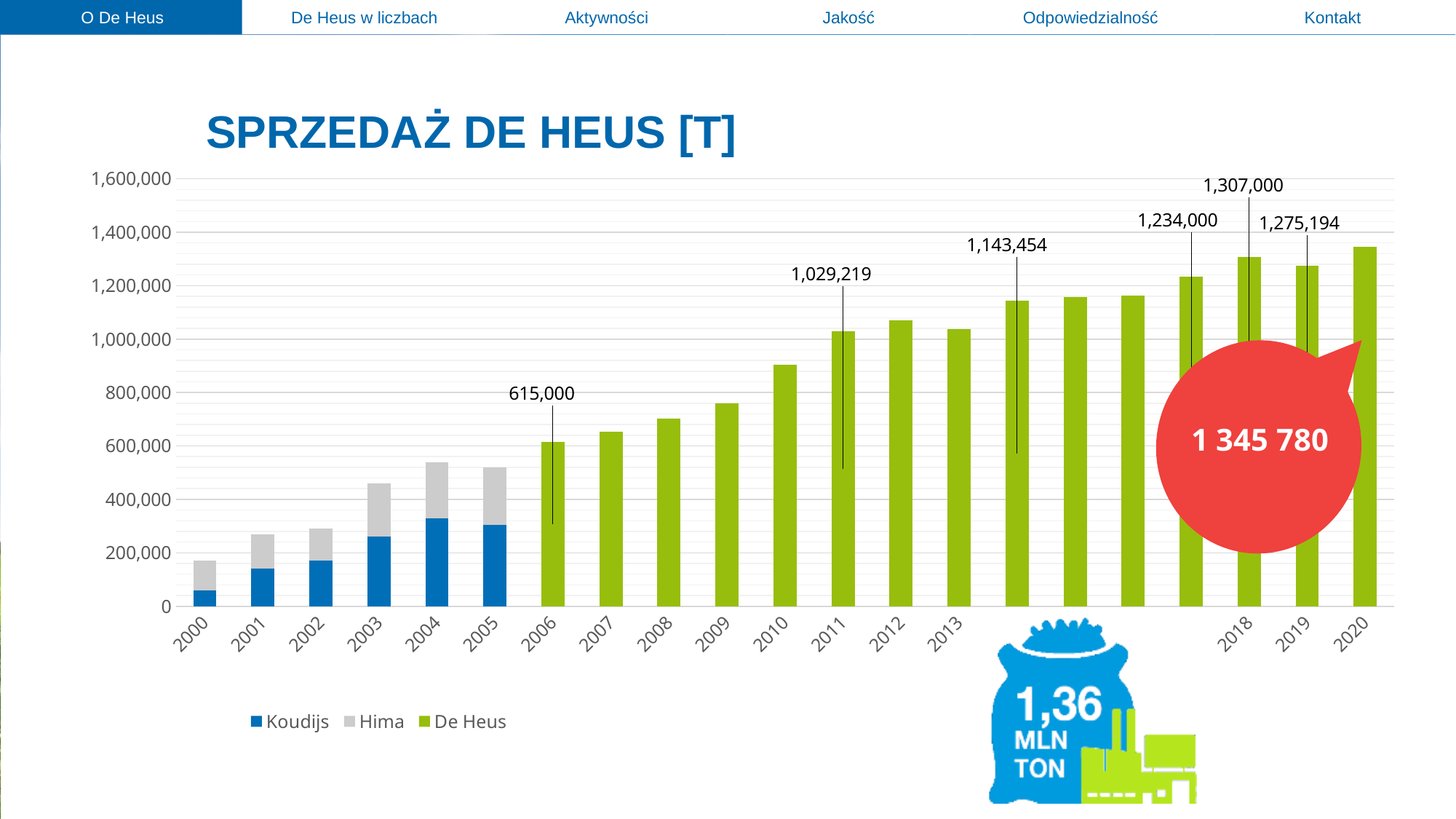
Is the value for 2010 greater or less than 1,000,000? less What kind of chart is shown on the slide? bar chart Which year has the larger De Heus sales value, 2018 or 2019? 2018 Do the De Heus values rise or fall from 2006 to 2013? rise Which year has the highest bar in the chart? 2020 How many series does the legend list? 3 What is the De Heus sales value shown for 2011? 1,029,219 What is the De Heus sales value shown for 2006? 615,000 What is the difference between the 2018 and 2019 De Heus sales values? 31,806 What is the De Heus sales value shown for 2019? 1,275,194 What is the De Heus sales value shown for 2018? 1,307,000